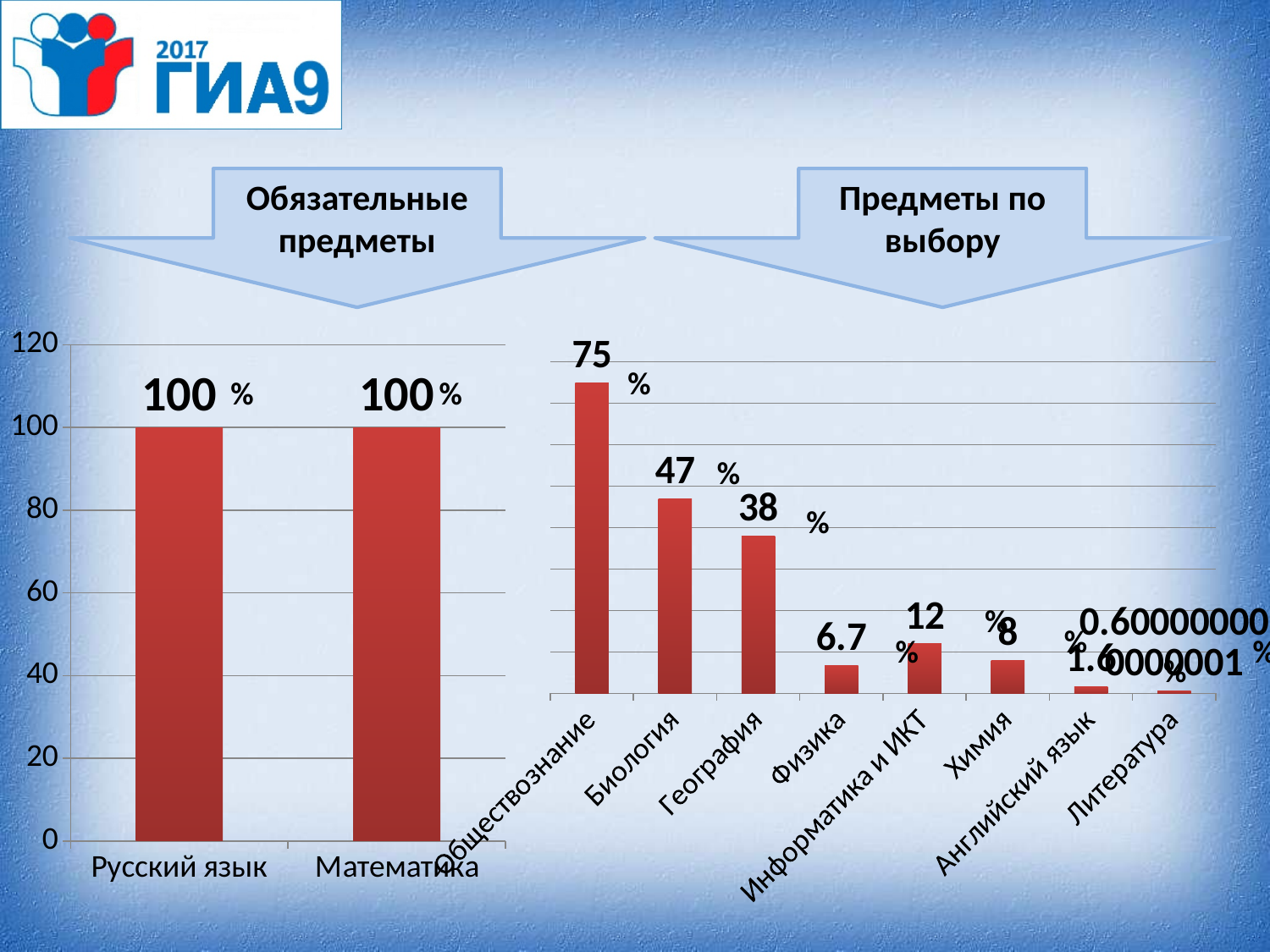
In the right chart ("Предметы по выбору"), what is the value for Физика? 6.7 What kind of chart is the left chart under "Обязательные предметы"? bar chart How many categories does the left chart ("Обязательные предметы") show? 2 In the right chart ("Предметы по выбору"), what is the value for География? 38 In the right chart ("Предметы по выбору"), what is the value for Обществознание? 75 In the right chart ("Предметы по выбору"), which is larger, the value for Физика or the value for Химия? Химия In the right chart ("Предметы по выбору"), which category has the highest value? Обществознание In the right chart ("Предметы по выбору"), what is the difference between the values for Обществознание and Биология? 28 In the left chart ("Обязательные предметы"), what is the value for Русский язык? 100 In the right chart ("Предметы по выбору"), what is the value for Биология? 47 In the right chart ("Предметы по выбору"), what is the value for Информатика и ИКТ? 12 How many categories does the right chart ("Предметы по выбору") show? 8